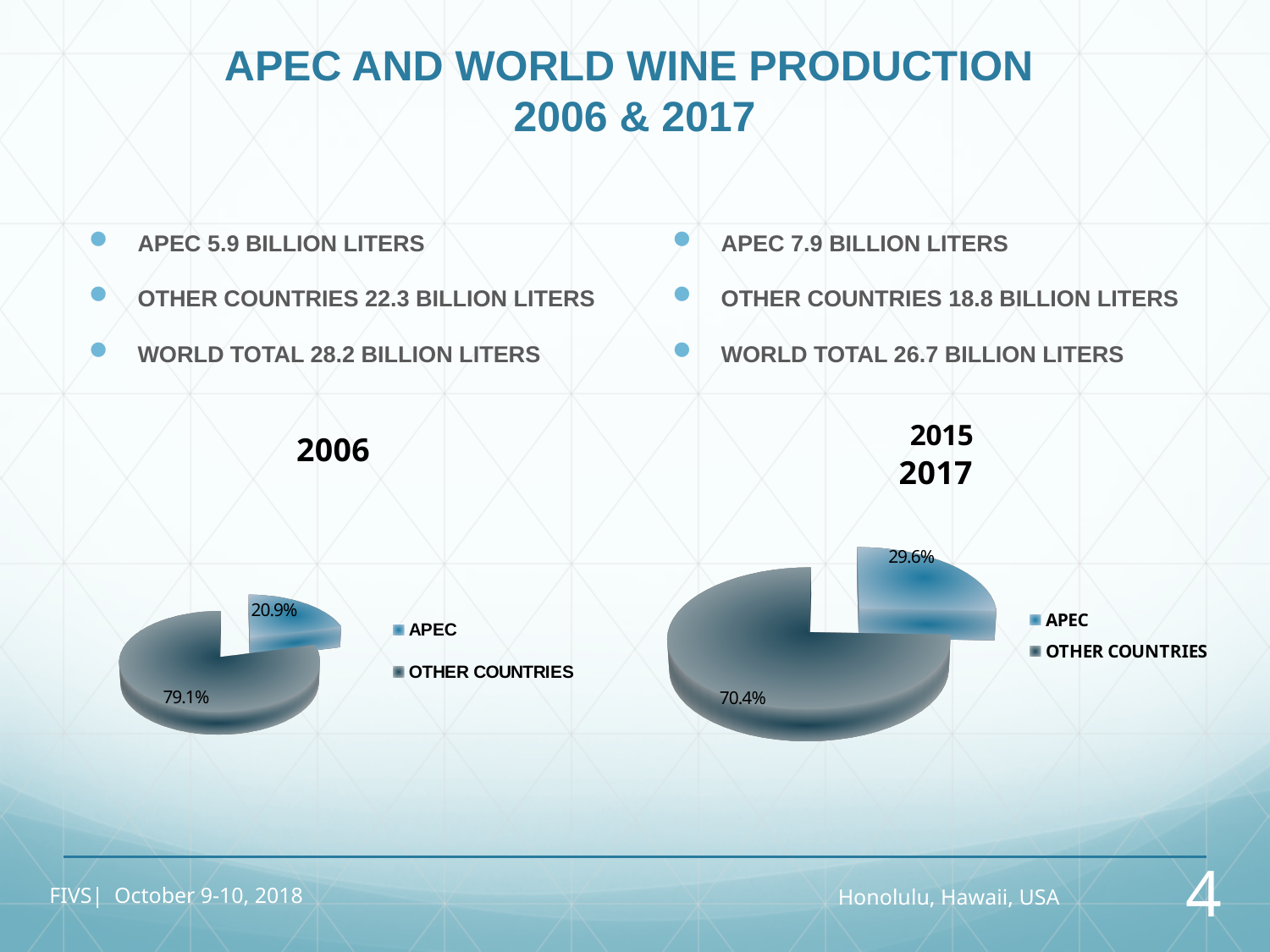
How many entries does the legend of the right-hand pie chart (titled 2015/2017) list? 2 What kind of chart is the left-hand chart titled 2006? Pie chart In the 2006 pie chart on the left, what share does APEC have? 20.9% In the right-hand pie chart (titled 2015/2017), what share does APEC have? 29.6% How many slices does the 2006 pie chart on the left have? 2 In the 2006 pie chart on the left, what is the difference between the OTHER COUNTRIES share and the APEC share? 58.2% In the right-hand pie chart (titled 2015/2017), which slice is the smallest? APEC Is the APEC share larger in the 2006 pie chart on the left or in the right-hand pie chart (titled 2015/2017)? The right-hand chart (2015/2017) In the right-hand pie chart (titled 2015/2017), what share do OTHER COUNTRIES have? 70.4% In the 2006 pie chart on the left, which slice is the largest? OTHER COUNTRIES In the 2006 pie chart on the left, what share do OTHER COUNTRIES have? 79.1% What are the two legend entries shown for the 2006 pie chart on the left? APEC and OTHER COUNTRIES